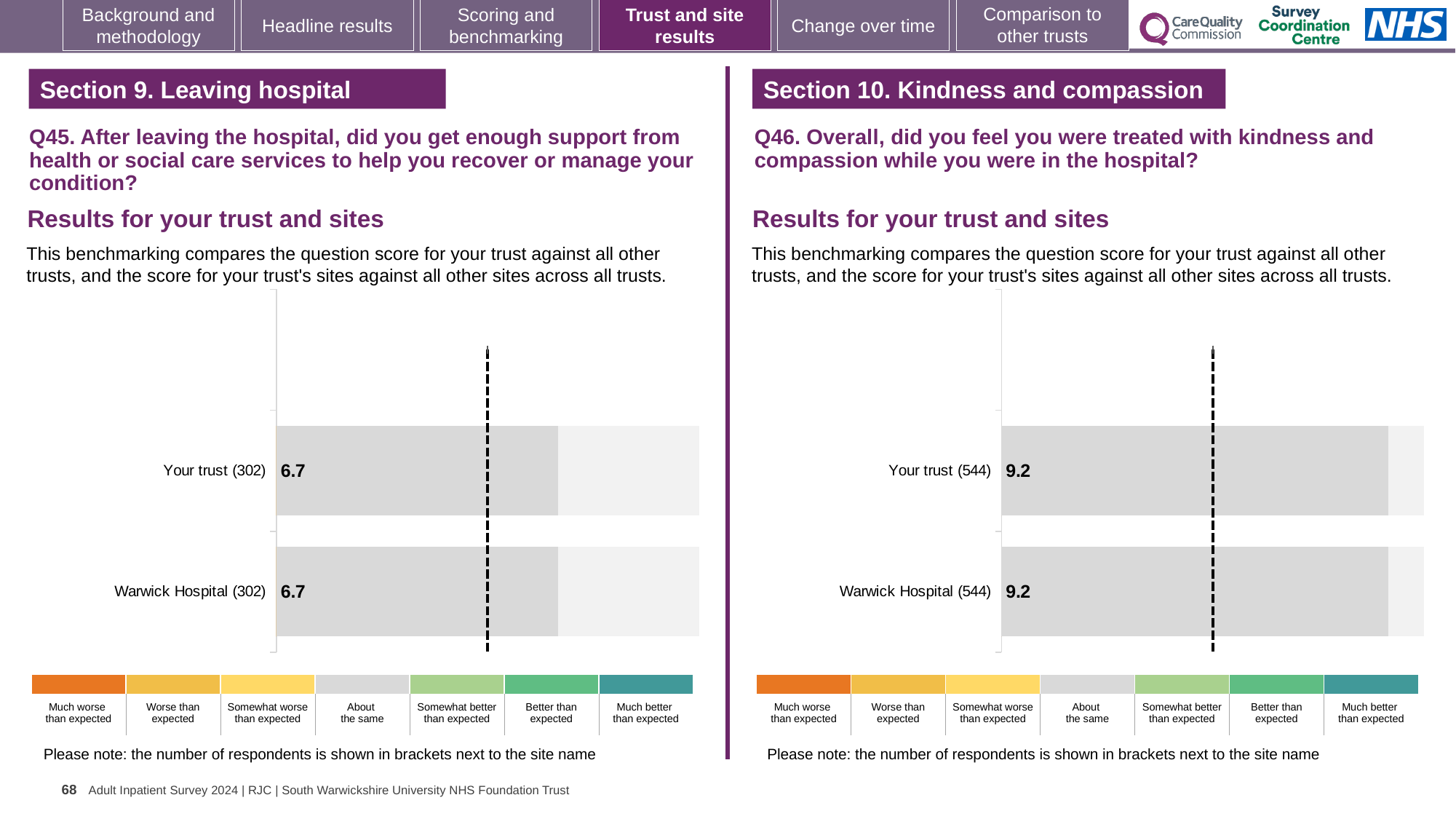
What kind of chart is the Q46 chart on the right? Bar chart In the Q46 chart on the right, how many respondents are shown in brackets for Warwick Hospital? 544 How many bars are plotted in the Q45 chart on the left? 2 In the Q45 chart on the left, how many respondents are shown in brackets for Your trust? 302 In the colour key below the Q46 chart on the right, what colour represents 'Much worse than expected'? Orange In the Q46 chart on the right, what is the score for Your trust? 9.2 How many bars are plotted in the Q46 chart on the right? 2 How many benchmark categories are shown in the colour key below the Q45 chart on the left? 7 In the Q45 chart on the left, what is the score for Warwick Hospital? 6.7 In the Q45 chart on the left, what is the score for Your trust? 6.7 In the Q45 chart on the left, what is the difference between the score for Your trust and the score for Warwick Hospital? 0 In the Q46 chart on the right, what is the score for Warwick Hospital? 9.2